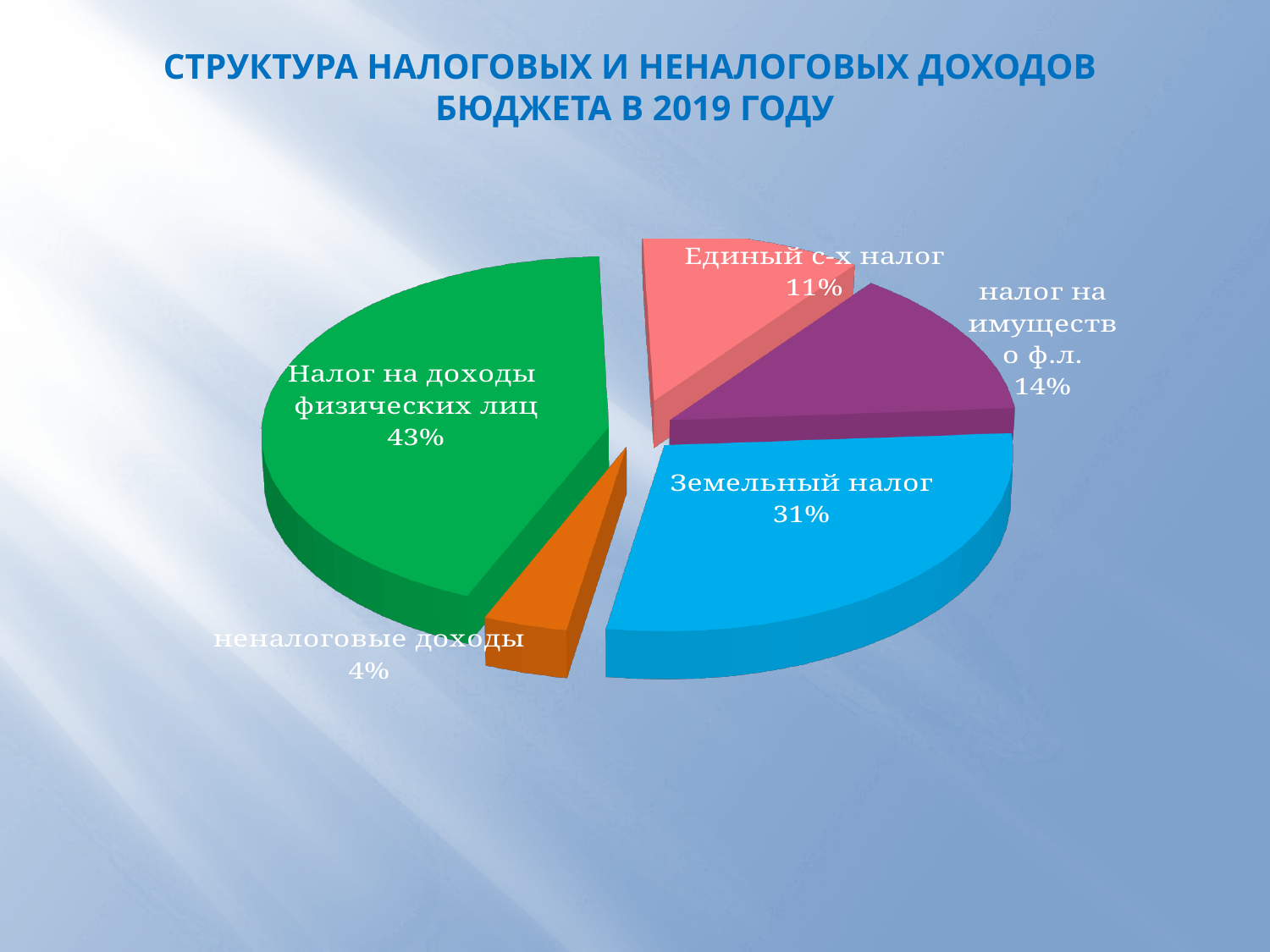
What share of the pie does "Налог на доходы физических лиц" have? 43% What kind of chart is shown on the slide? pie chart How many slices does the pie chart have? 5 What share of the pie does "неналоговые доходы" have? 4% What share of the pie does "Земельный налог" have? 31% Which is larger: "налог на имущество ф.л." or "Единый с-х налог"? налог на имущество ф.л. Which category has the largest slice of the pie? Налог на доходы физических лиц Which category has the smallest slice of the pie? неналоговые доходы What is the difference in percentage points between "Налог на доходы физических лиц" and "Земельный налог"? 12% What is the title of the chart on the slide? СТРУКТУРА НАЛОГОВЫХ И НЕНАЛОГОВЫХ ДОХОДОВ БЮДЖЕТА В 2019 ГОДУ